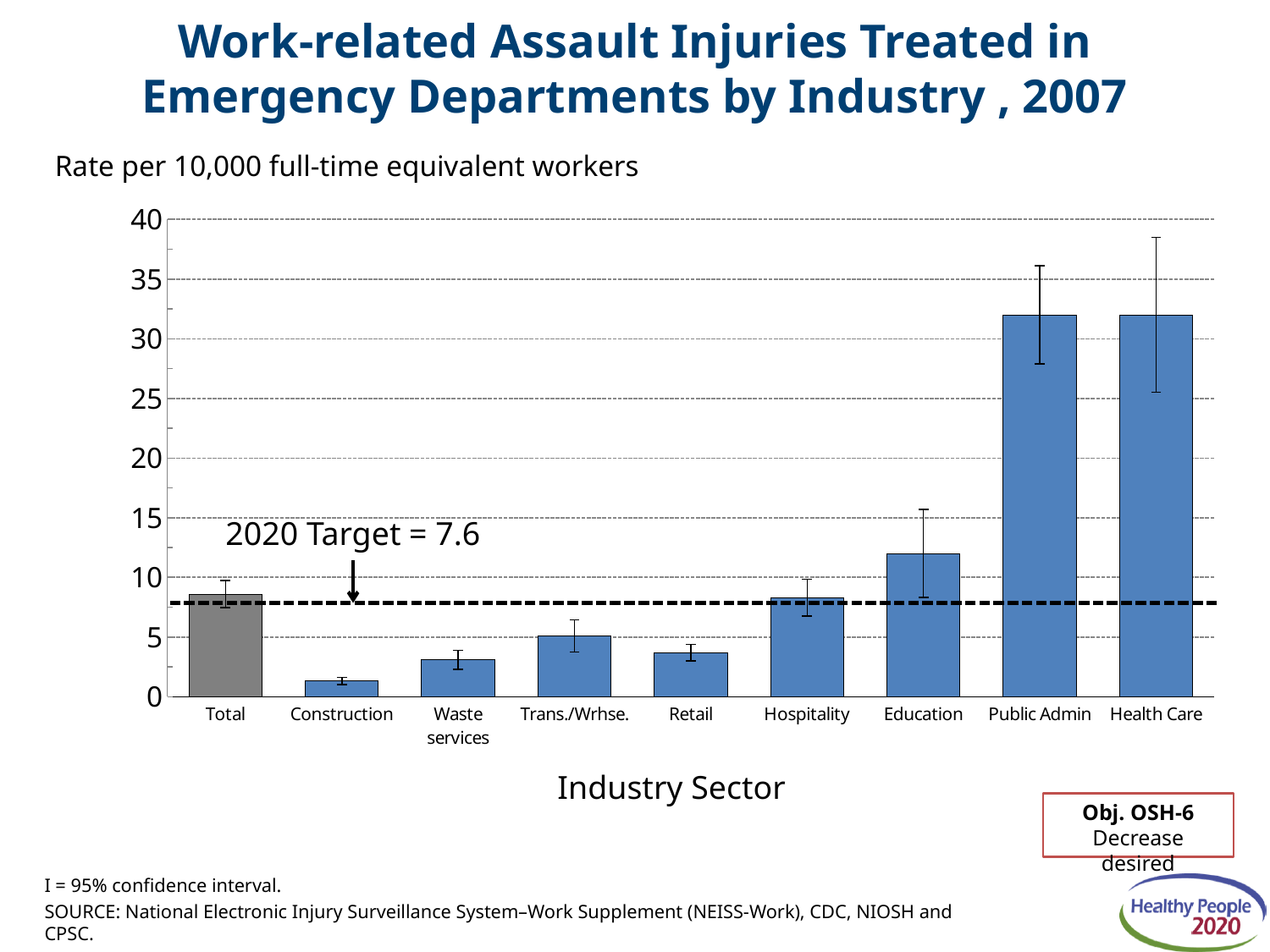
Is the value for Education greater or less than 10? greater Is the value for Public Admin greater or less than 30? greater What kind of chart is shown on the slide? bar chart Is the value for Health Care greater or less than 25? greater How many industry sector categories are plotted on the x axis? 9 What is the 2020 Target value shown on the chart? 7.6 Which industry sector has the lowest rate of work-related assault injuries? Construction Which has a higher rate, Education or Retail? Education What is the title of the x axis? Industry Sector